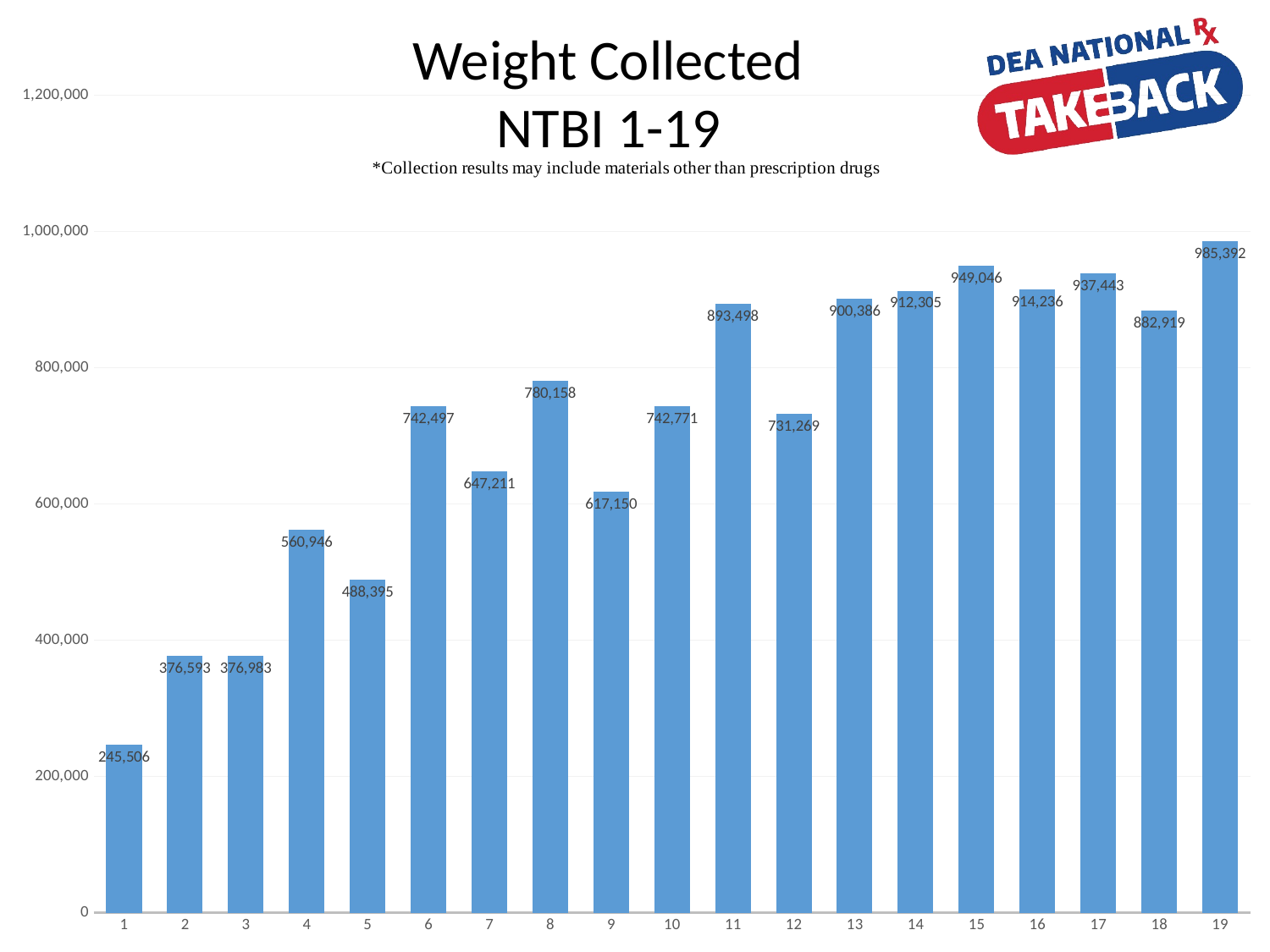
What is the weight collected for NTBI 11? 893,498 What is the difference between the weight collected for NTBI 19 and NTBI 1? 739,886 Which NTBI has the highest weight collected? 19 How many NTBI events are shown on the chart? 19 What is the weight collected for NTBI 1? 245,506 What is the weight collected for NTBI 17? 937,443 What is the difference between the weight collected for NTBI 15 and NTBI 14? 36,741 Which has a larger weight collected, NTBI 8 or NTBI 6? NTBI 8 What is the title of the chart? Weight Collected NTBI 1-19 Is the value for NTBI 12 greater or less than 600,000? greater What kind of chart is shown on the slide? bar chart Which NTBI has the lowest weight collected? 1